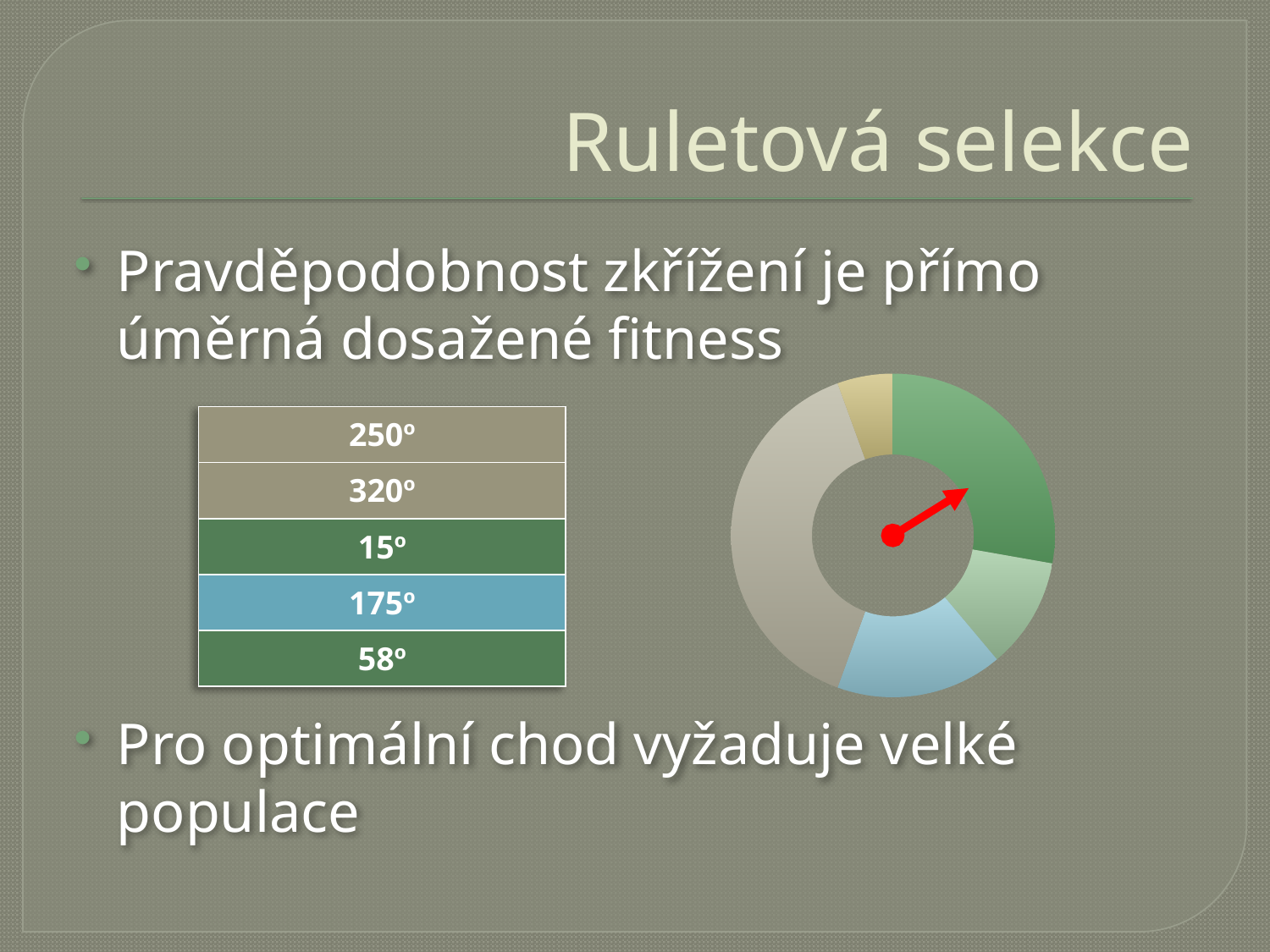
What kind of chart is shown on the right side of the slide? doughnut chart In the doughnut chart, which is larger: the grey/beige slice or the blue slice? the grey/beige slice Which slice of the doughnut chart is the largest? the grey/beige slice How many slices does the doughnut chart on the slide have? 5 In the doughnut chart, which is larger: the dark green slice or the yellow/tan slice? the dark green slice Which slice of the doughnut chart is the smallest? the yellow/tan slice Which slice of the doughnut chart does the red arrow point to? the dark green slice Does the doughnut chart on the slide have a legend? No